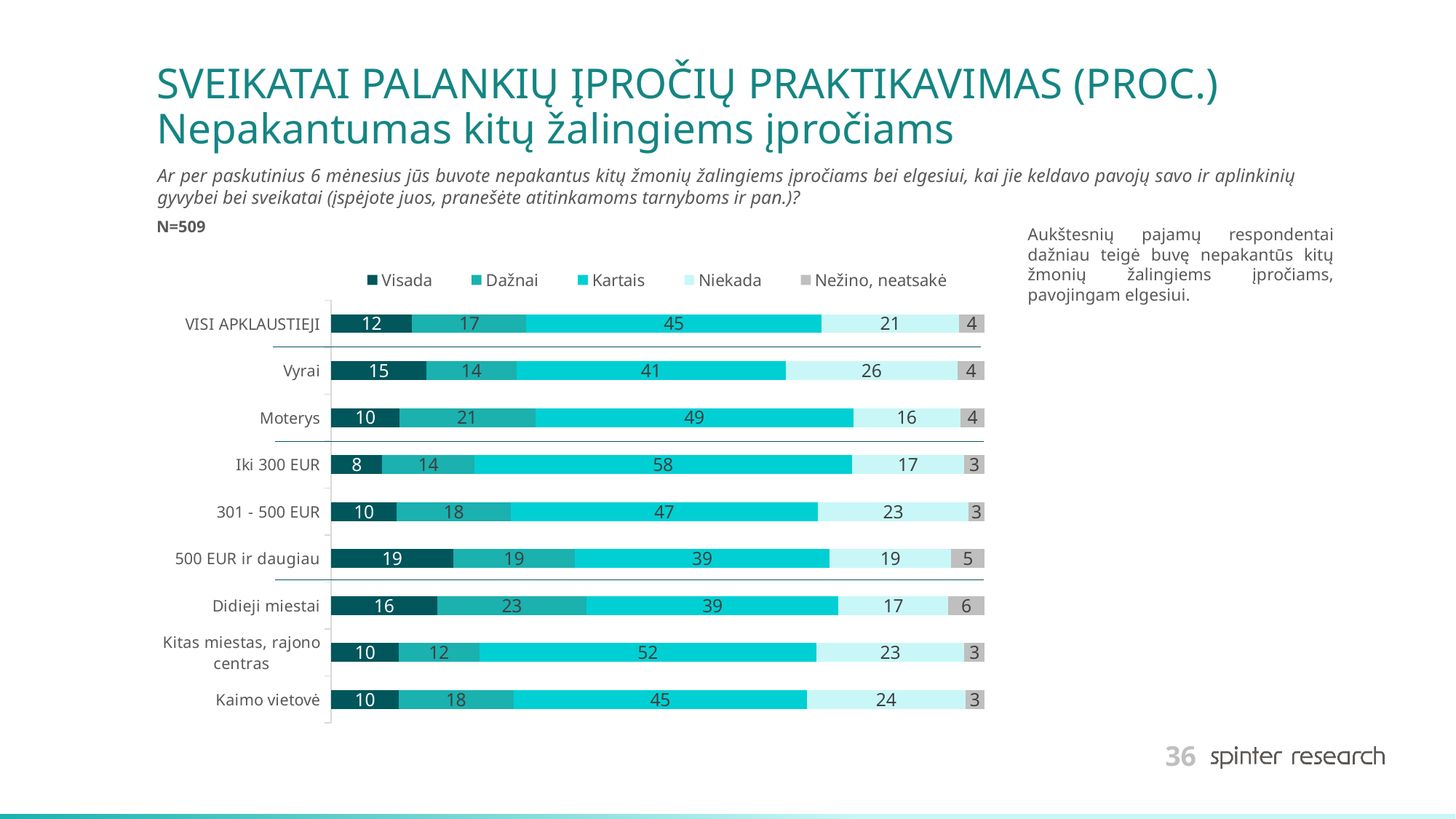
Which is larger: the "Niekada" value for Moterys or for Vyrai? Vyrai Which category has the lowest "Visada" value? Iki 300 EUR What is the "Visada" value for 500 EUR ir daugiau? 19 What kind of chart is shown on the slide? Stacked bar chart What is the difference between the "Kartais" values for Kitas miestas, rajono centras and Kaimo vietovė? 7 What is the sample size (N) stated on the slide? N=509 How many series does the legend list? 5 What is the "Dažnai" value for Didieji miestai? 23 Which category has the highest "Kartais" value? Iki 300 EUR What is the "Niekada" value for Vyrai? 26 How many categories are shown on the chart? 9 What is the "Kartais" value for VISI APKLAUSTIEJI? 45